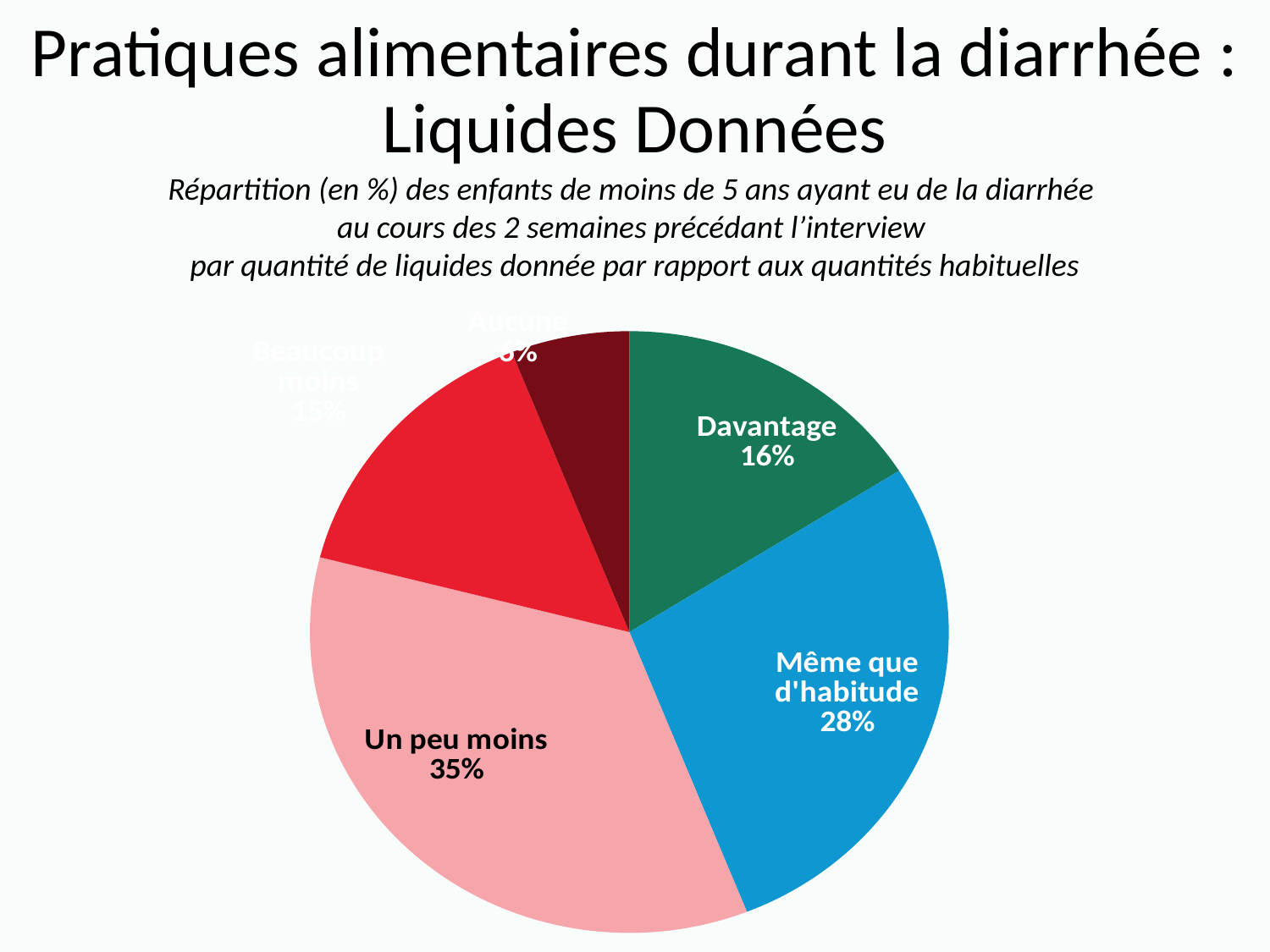
How many slices does the pie chart have? 5 What is the title of the slide? Pratiques alimentaires durant la diarrhée : Liquides Données What is the difference between 'Un peu moins' and 'Même que d'habitude'? 7 percentage points Which is larger, 'Davantage' or 'Même que d'habitude'? Même que d'habitude Which category has the largest share of the pie? Un peu moins What is the difference between 'Même que d'habitude' and 'Davantage'? 12 percentage points What is the value for 'Un peu moins'? 35% What share of the pie does 'Un peu moins' represent? 35% What is the value for 'Même que d'habitude'? 28% What kind of chart is shown on the slide? pie chart What colour is the 'Même que d'habitude' slice? blue What percentage of children received 'Davantage' liquids? 16%